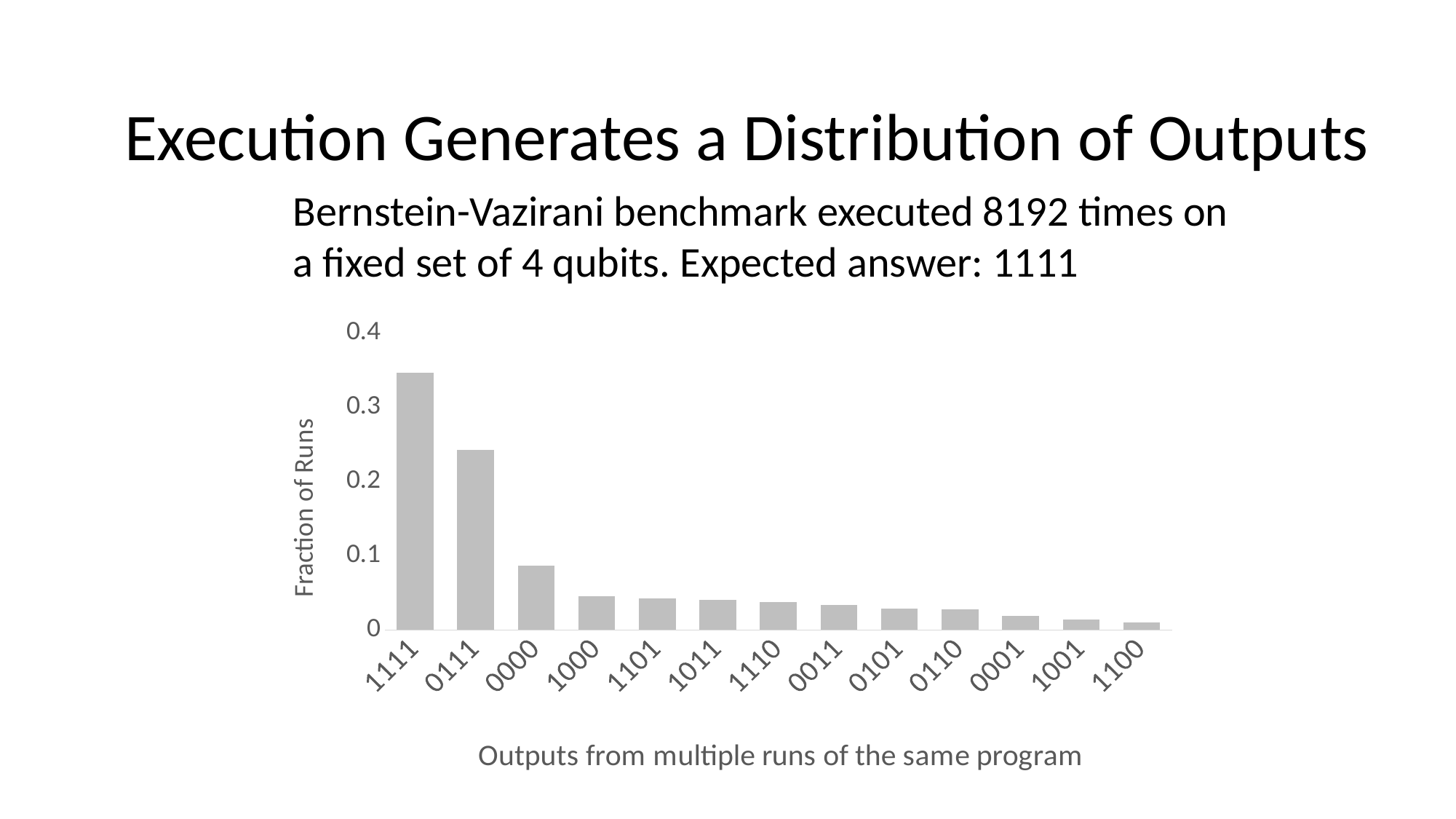
Which output has a larger fraction of runs, 1111 or 0111? 1111 What kind of chart is shown on the slide? bar chart Is the fraction of runs for 0111 greater or less than 0.3? less Which output has the highest fraction of runs? 1111 Which output has a larger fraction of runs, 0000 or 1000? 0000 Is the fraction of runs for 1111 greater or less than 0.3? greater Is the fraction of runs for 0000 greater or less than 0.1? less What is the label on the vertical axis of the chart? Fraction of Runs Which output has the lowest fraction of runs? 1100 How many output categories are shown on the x axis of the chart? 13 Do the bar values rise or fall moving from left to right along the x axis? fall